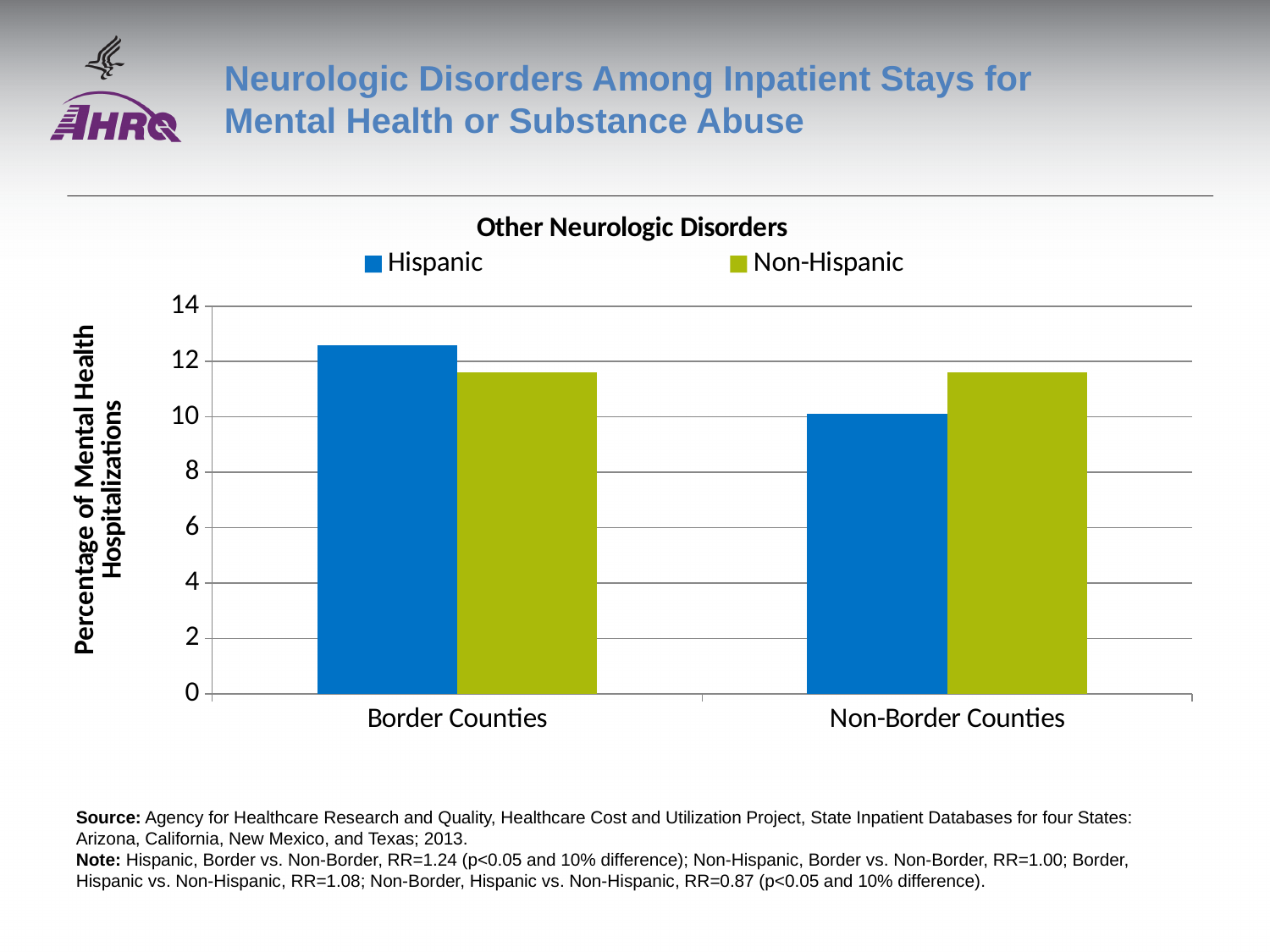
In Non-Border Counties, which is larger: the Hispanic value or the Non-Hispanic value? Non-Hispanic Is the Hispanic value for Border Counties greater or less than 12? greater Is the Non-Hispanic value for Border Counties greater or less than 10? greater How many categories are shown on the x axis? 2 What colour are the Non-Hispanic bars? green Is the Hispanic value for Non-Border Counties greater or less than 12? less What kind of chart is shown on the slide? bar chart In Border Counties, which is larger: the Hispanic value or the Non-Hispanic value? Hispanic Which bar is the shortest in the chart? Hispanic, Non-Border Counties Which bar is the tallest in the chart? Hispanic, Border Counties How many series does the legend list? 2 What is the title of the chart? Other Neurologic Disorders